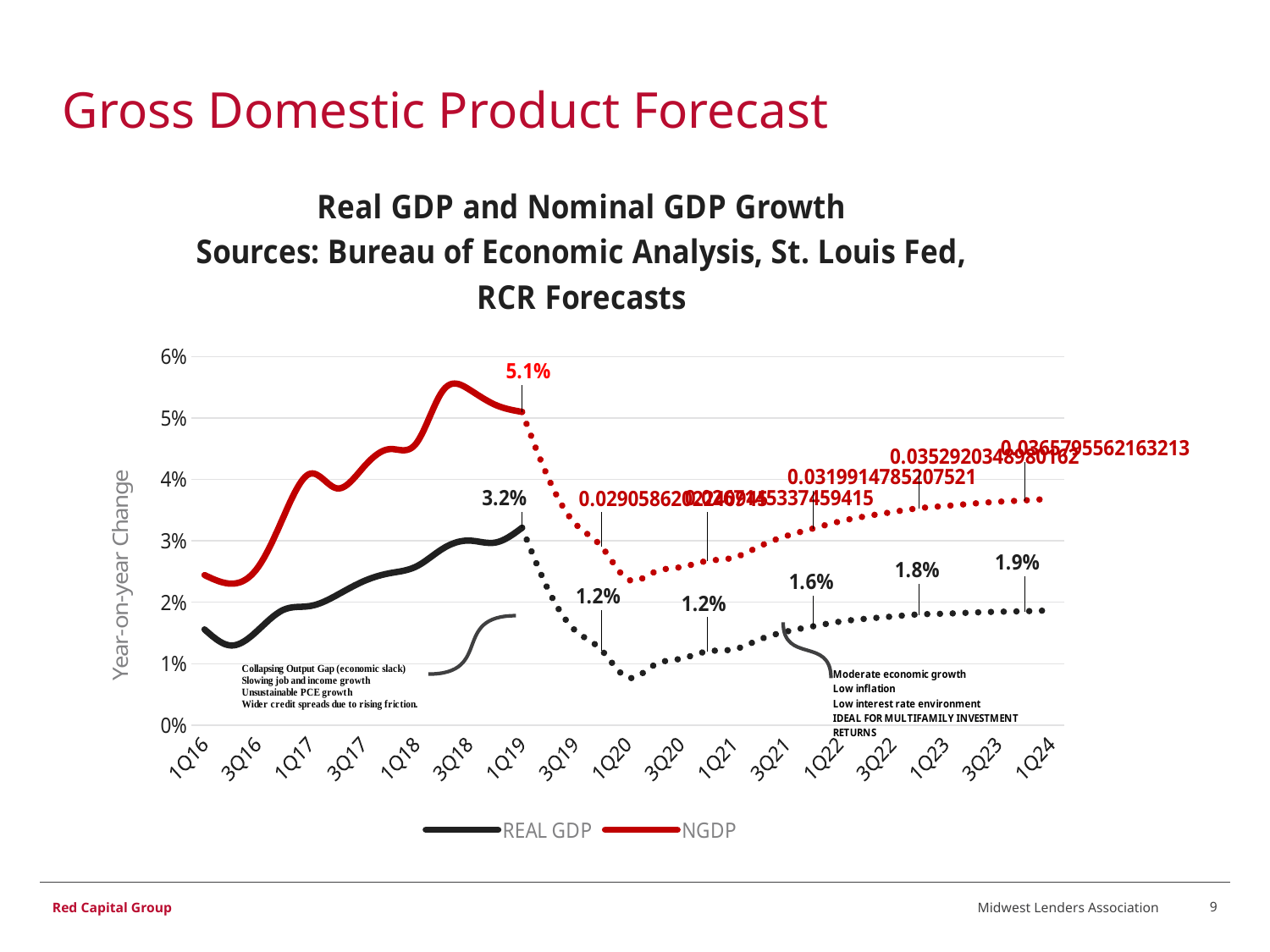
Which series is higher at 1Q19, REAL GDP or NGDP? NGDP What is the labeled value of REAL GDP at 1Q19? 3.2% Does the REAL GDP line rise or fall from 1Q20 to 1Q24? Rises Is the value for REAL GDP at 1Q16 greater or less than 2%? less What is the title of the vertical axis? Year-on-year Change What type of chart is shown on the slide? Line chart What is the difference between the NGDP and REAL GDP labeled values at 1Q19? 1.9 percentage points How many series does the legend list? 2 What is the labeled value of NGDP at 1Q19? 5.1% Is the value for NGDP at 1Q20 greater or less than 3%? less What is the labeled value of REAL GDP at 1Q24? 1.9% What is the labeled value of REAL GDP at 1Q23? 1.8%